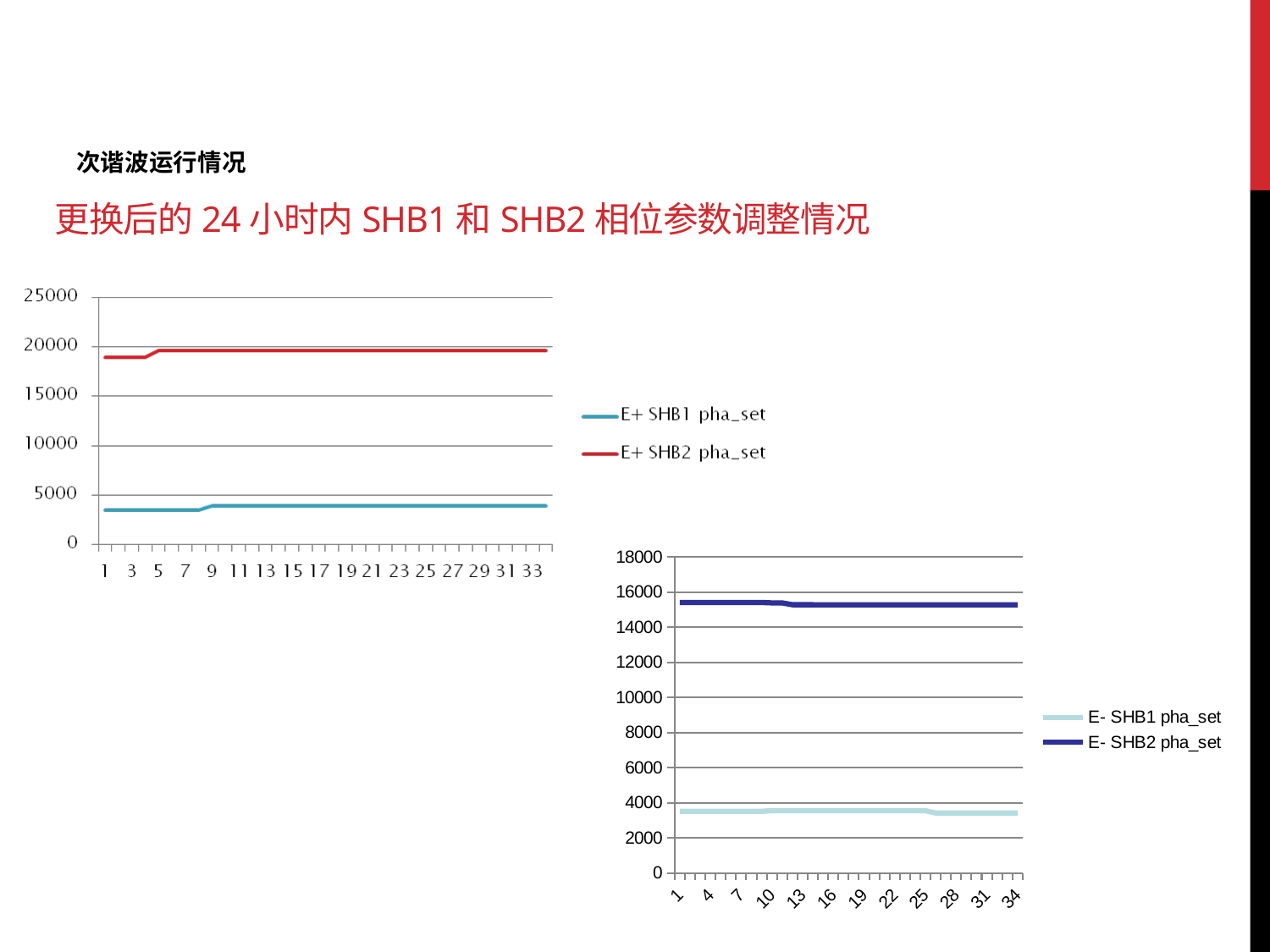
In the left chart, which series has the higher values, E+ SHB1 pha_set or E+ SHB2 pha_set? E+ SHB2 pha_set In the right chart, is the value of E- SHB2 pha_set greater or less than 14000? greater In the left chart, is the value of E+ SHB2 pha_set greater or less than 15000? greater What kind of chart is the chart on the left of the slide? line chart How many series does the legend of the left chart list? 2 In the left chart, is the value of E+ SHB1 pha_set greater or less than 5000? less In the right chart, does the E- SHB2 pha_set line rise or fall along the x axis? fall In the left chart, does the E+ SHB2 pha_set line rise or fall along the x axis? rise How many series does the legend of the right chart list? 2 In the right chart, which series has the lower values, E- SHB1 pha_set or E- SHB2 pha_set? E- SHB1 pha_set What kind of chart is the chart on the right of the slide? line chart